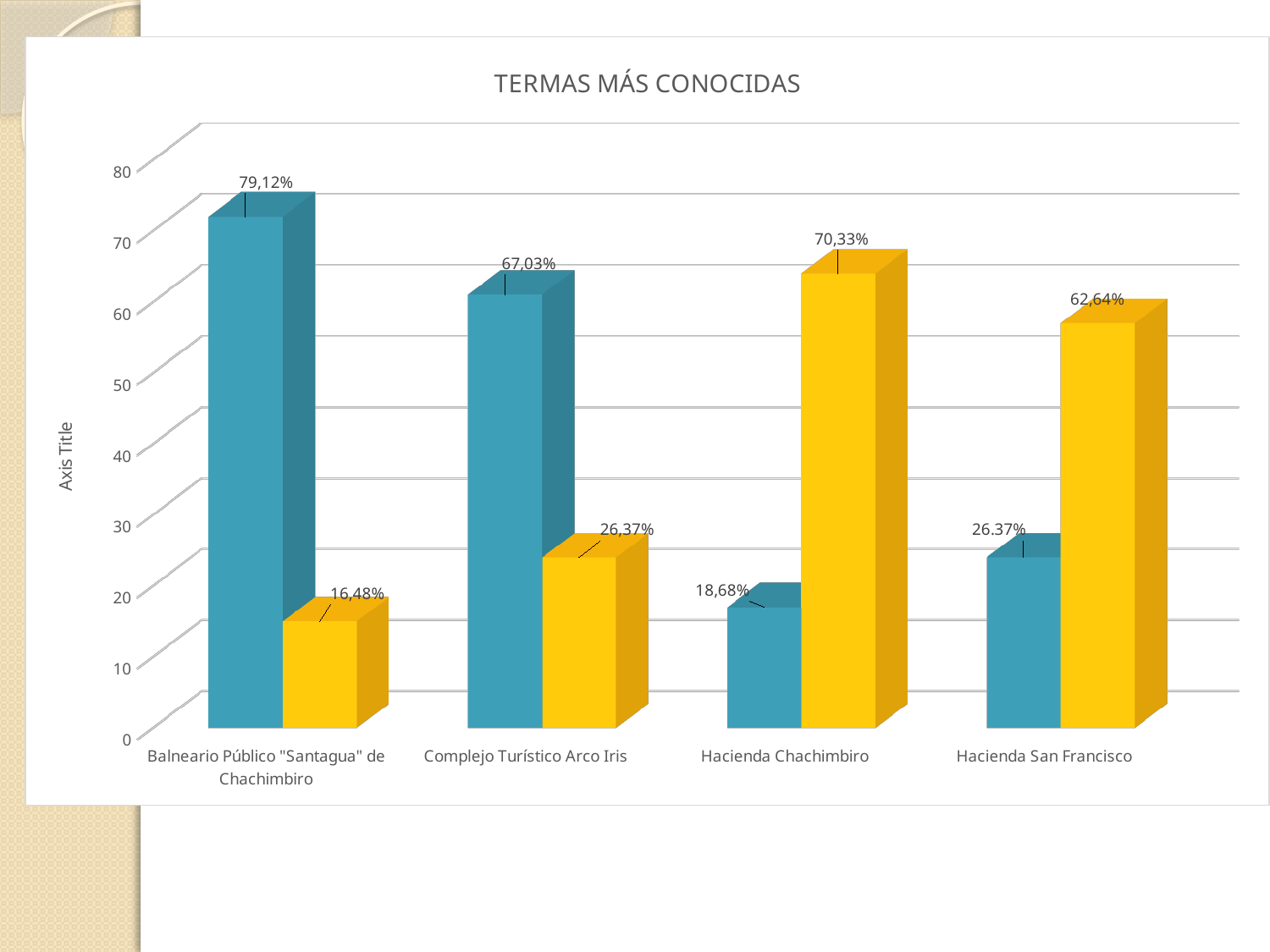
What is the value of the blue bar for Hacienda Chachimbiro? 18,68% How many categories are shown on the x axis? 4 What is the value of the yellow bar for Complejo Turístico Arco Iris? 26,37% What is the value of the blue bar for Balneario Público "Santagua" de Chachimbiro? 79,12% What is the title of the chart? TERMAS MÁS CONOCIDAS Which is larger for Hacienda San Francisco, the blue bar or the yellow bar? the yellow bar Which category has the lowest yellow bar? Balneario Público "Santagua" de Chachimbiro Which category has the highest blue bar? Balneario Público "Santagua" de Chachimbiro What kind of chart is shown on the slide? bar chart What is the value of the yellow bar for Hacienda Chachimbiro? 70,33% What is the difference between the blue bar and the yellow bar for Complejo Turístico Arco Iris? 40,66% What is the value of the yellow bar for Hacienda San Francisco? 62,64%